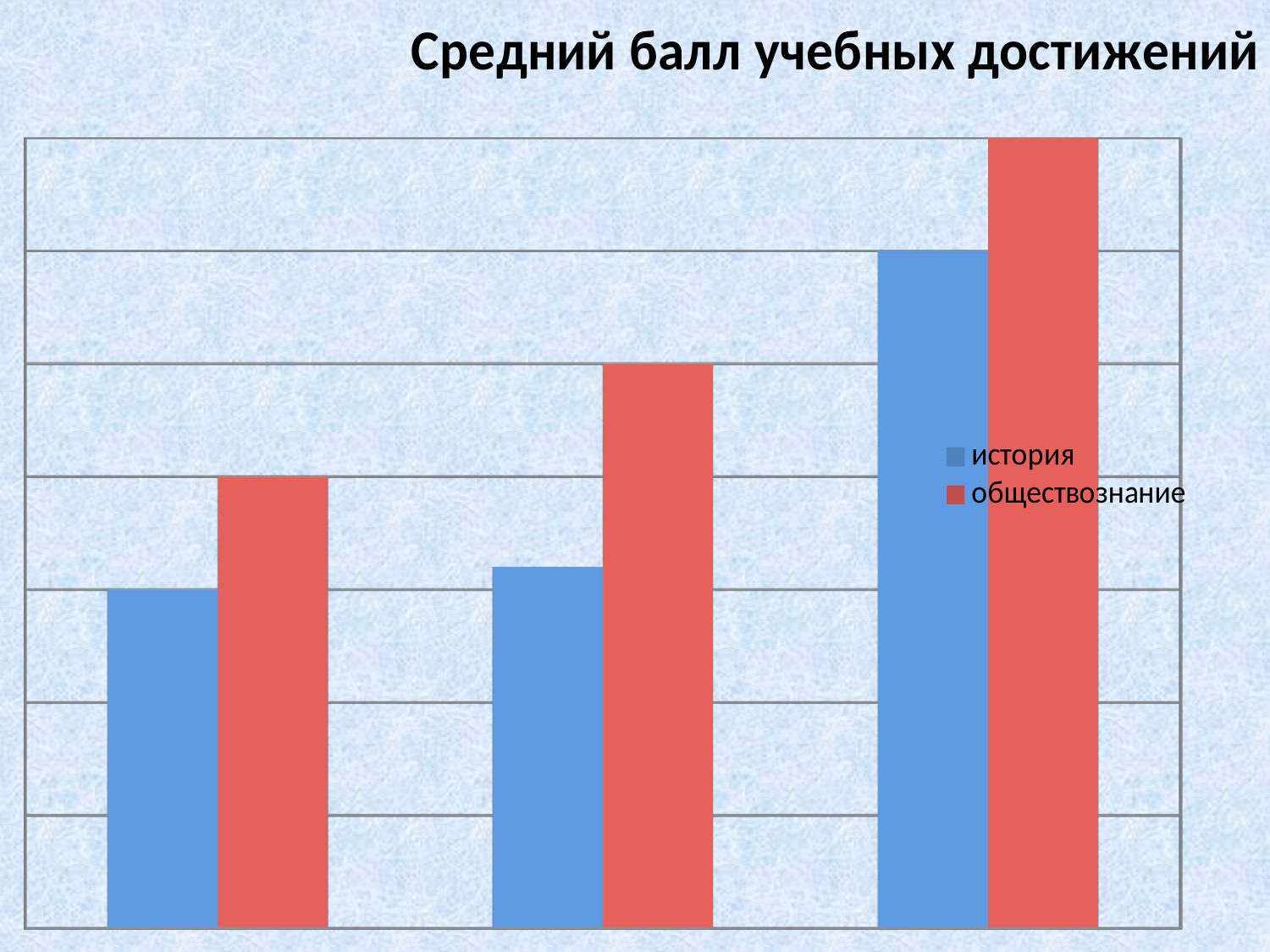
How many bars are plotted in total in the chart? 6 In the leftmost group of bars, which series has the larger value, история or обществознание? обществознание Which group of bars (leftmost, middle or rightmost) has the tallest bar in the chart? rightmost Do the values for история rise or fall from left to right across the groups? rise What kind of chart is shown on the slide? bar chart What is the title of the chart? Средний балл учебных достижений How many series does the legend list? 2 Which series is shown in red in the chart? обществознание In the rightmost group of bars, which series has the larger value, история or обществознание? обществознание How many groups of bars are plotted in the chart? 3 Which group of bars (leftmost, middle or rightmost) has the shortest bar in the chart? leftmost Do the values for обществознание rise or fall from left to right across the groups? rise